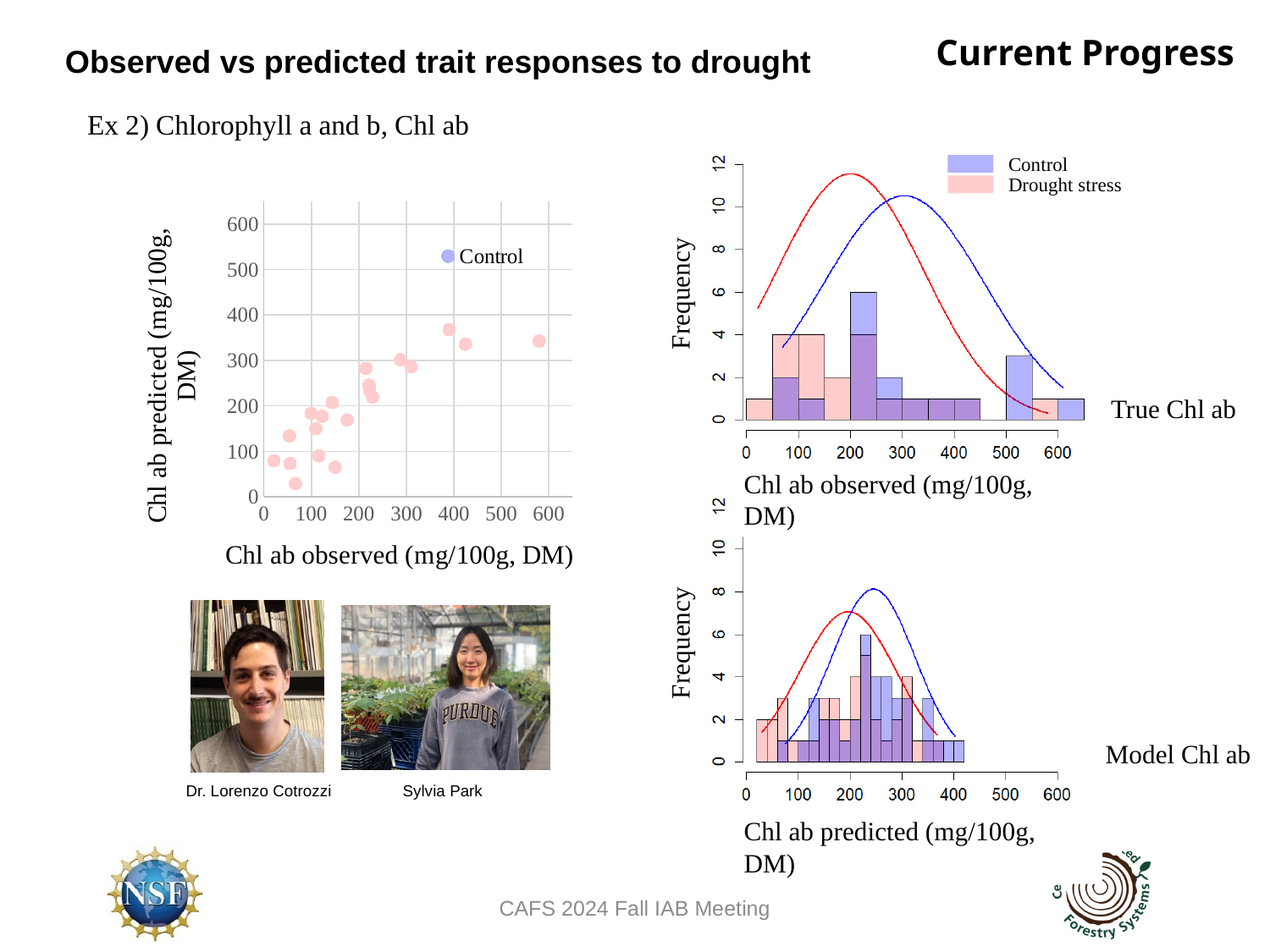
What kind of chart is the 'True Chl ab' chart on the right? Bar chart (histogram) How many series does the legend of the 'True Chl ab' chart list? 2 On the 'True Chl ab' chart, is the tallest bar's frequency greater or less than 4? Greater On the scatter plot, do the predicted Chl ab values generally rise or fall as observed Chl ab increases? Rise On the 'True Chl ab' chart, which colour represents Drought stress? Pink On the 'Model Chl ab' chart, is the frequency of the bar at 0–50 greater or less than 4? Less On the 'Model Chl ab' chart, what is the highest frequency reached by any bar? 6 On the 'True Chl ab' chart, what is the highest frequency reached by any bar? 6 What are the two legend entries on the 'True Chl ab' chart? Control and Drought stress On the scatter plot, is the predicted value for the point with the highest observed Chl ab (near 580) greater or less than 400? Less What kind of chart is the chart on the left with axes 'Chl ab observed' and 'Chl ab predicted'? Scatter plot